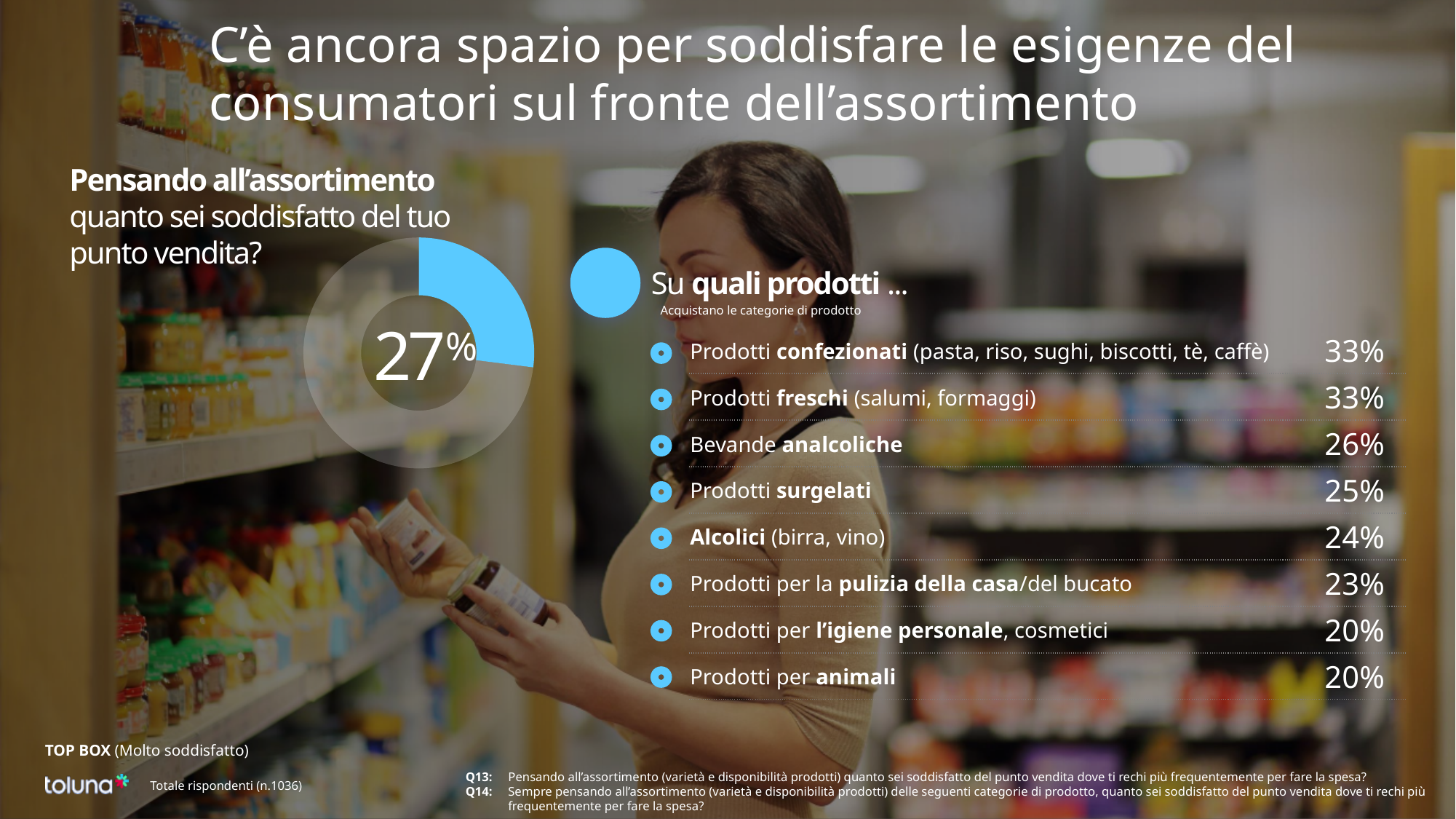
In the 'Su quali prodotti' list on the right, what is the value for Bevande analcoliche? 26% What is the total number of respondents stated at the bottom of the slide? 1036 In the donut chart on the left, is the highlighted share greater or less than 50%? less In the 'Su quali prodotti' list on the right, which two categories share the highest value of 33%? Prodotti confezionati and Prodotti freschi In the 'Su quali prodotti' list on the right, which is larger: Prodotti surgelati or Bevande analcoliche? Bevande analcoliche In the 'Su quali prodotti' list on the right, what is the value for Alcolici? 24% In the 'Su quali prodotti' list on the right, what is the difference between Prodotti freschi and Prodotti per animali? 13 percentage points In the 'Su quali prodotti' list on the right, what is the value for Prodotti per la pulizia della casa/del bucato? 23% What kind of chart is used to show the 27% satisfaction figure on the left of the slide? Pie (donut) chart In the 'Su quali prodotti' list on the right, what is the value for Prodotti confezionati? 33% In the donut chart on the left, what percentage of respondents are 'Molto soddisfatto' (top box) with the assortment of their store? 27% How many product categories are listed in the 'Su quali prodotti' section on the right? 8